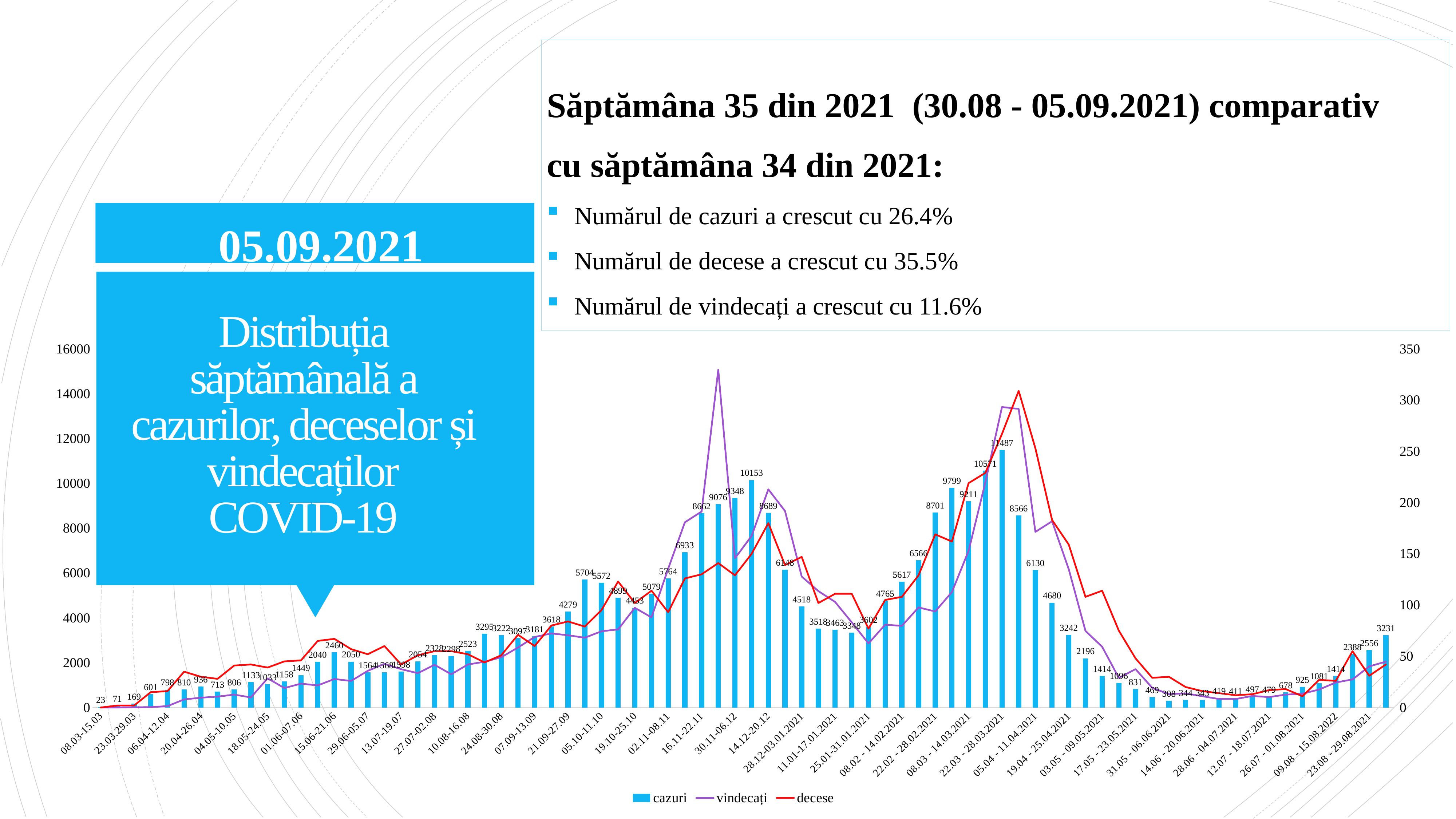
Which week has the lowest number of cazuri? 08.03-15.03 What kind of chart is shown on the slide? bar and line chart What is the value of cazuri for the week 30.11-06.12? 9348 Which week has the highest number of cazuri (bars)? 22.03 - 28.03.2021 Which week has more cazuri: 30.11-06.12 or 05.04 - 11.04.2021? 30.11-06.12 What is the value of cazuri for the week 23.08 - 29.08.2021? 2556 What is the difference in cazuri between the weeks 22.03 - 28.03.2021 and 05.04 - 11.04.2021? 5357 What is the value of cazuri for the week 19.04 - 25.04.2021? 3242 What are the three series listed in the legend? cazuri, vindecați, decese How many series does the legend list? 3 What colour are the bars for cazuri? blue What is the highest value of cazuri shown on the chart? 11487